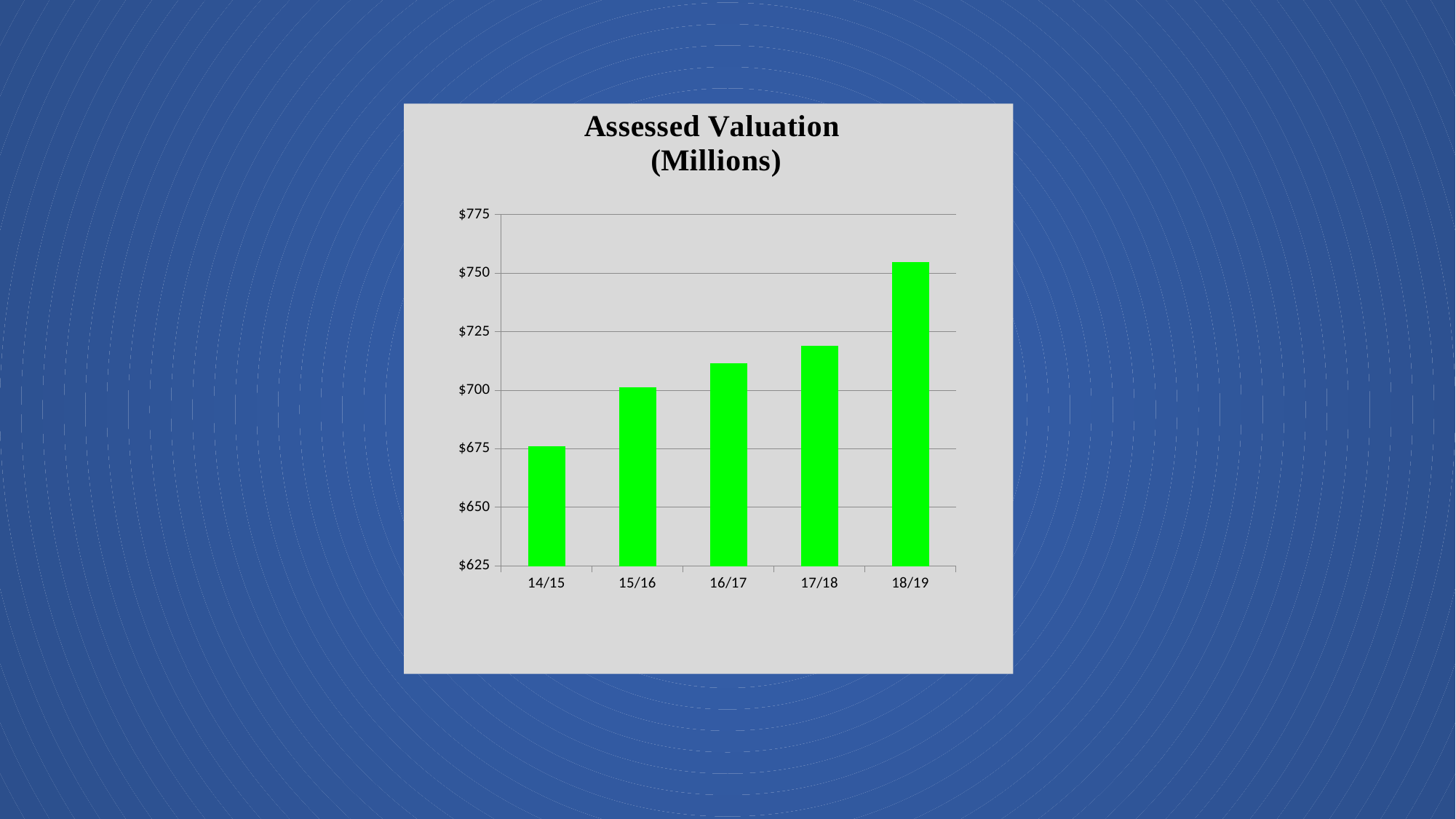
What is the title of the chart? Assessed Valuation (Millions) Do the values rise or fall from 14/15 to 18/19? rise Which year has the lowest assessed valuation? 14/15 How many fiscal years are shown on the x axis? 5 Is the value for 17/18 greater or less than $725? less What colour are the bars in the chart? green What kind of chart is shown on the slide? bar chart Which is larger, the value for 15/16 or the value for 17/18? 17/18 Is the value for 14/15 greater or less than $700? less Which year has the highest assessed valuation? 18/19 Is the value for 16/17 greater or less than $700? greater